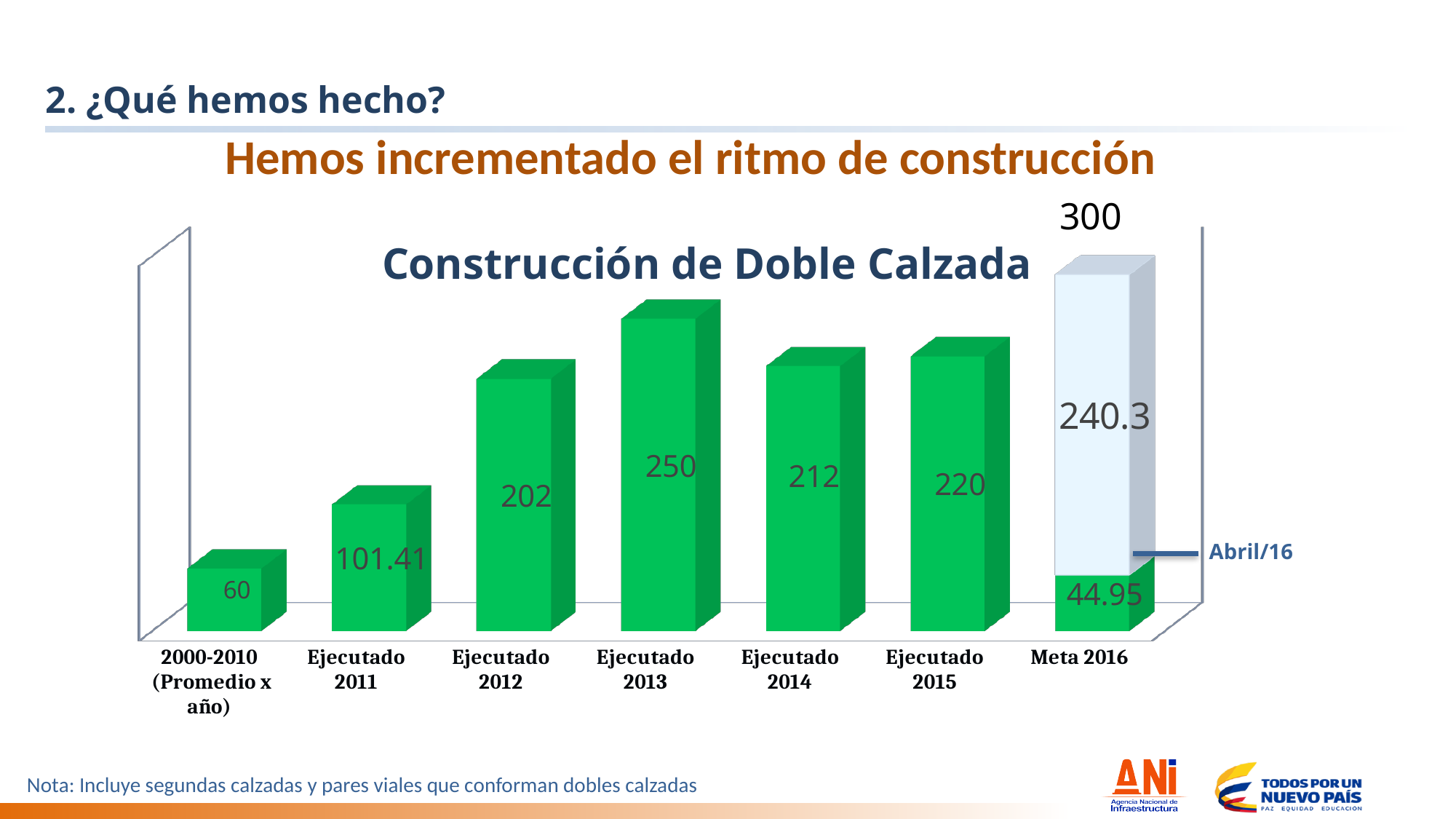
What kind of chart is shown on the slide? Bar chart Which is larger, the value for Ejecutado 2014 or Ejecutado 2015? Ejecutado 2015 How many categories are shown on the x axis? 7 What is the difference between the values for Ejecutado 2015 and Ejecutado 2014? 8 What value is printed on the green (lower) portion of the Meta 2016 bar? 44.95 What is the value for Ejecutado 2013? 250 What is the difference between the values for Ejecutado 2013 and Ejecutado 2012? 48 What is the value for the 2000-2010 (Promedio x año) category? 60 Which of the Ejecutado years has the highest value? Ejecutado 2013 Which category has the lowest value? 2000-2010 (Promedio x año) What value is printed above the Meta 2016 bar? 300 What is the value for Ejecutado 2011? 101.41